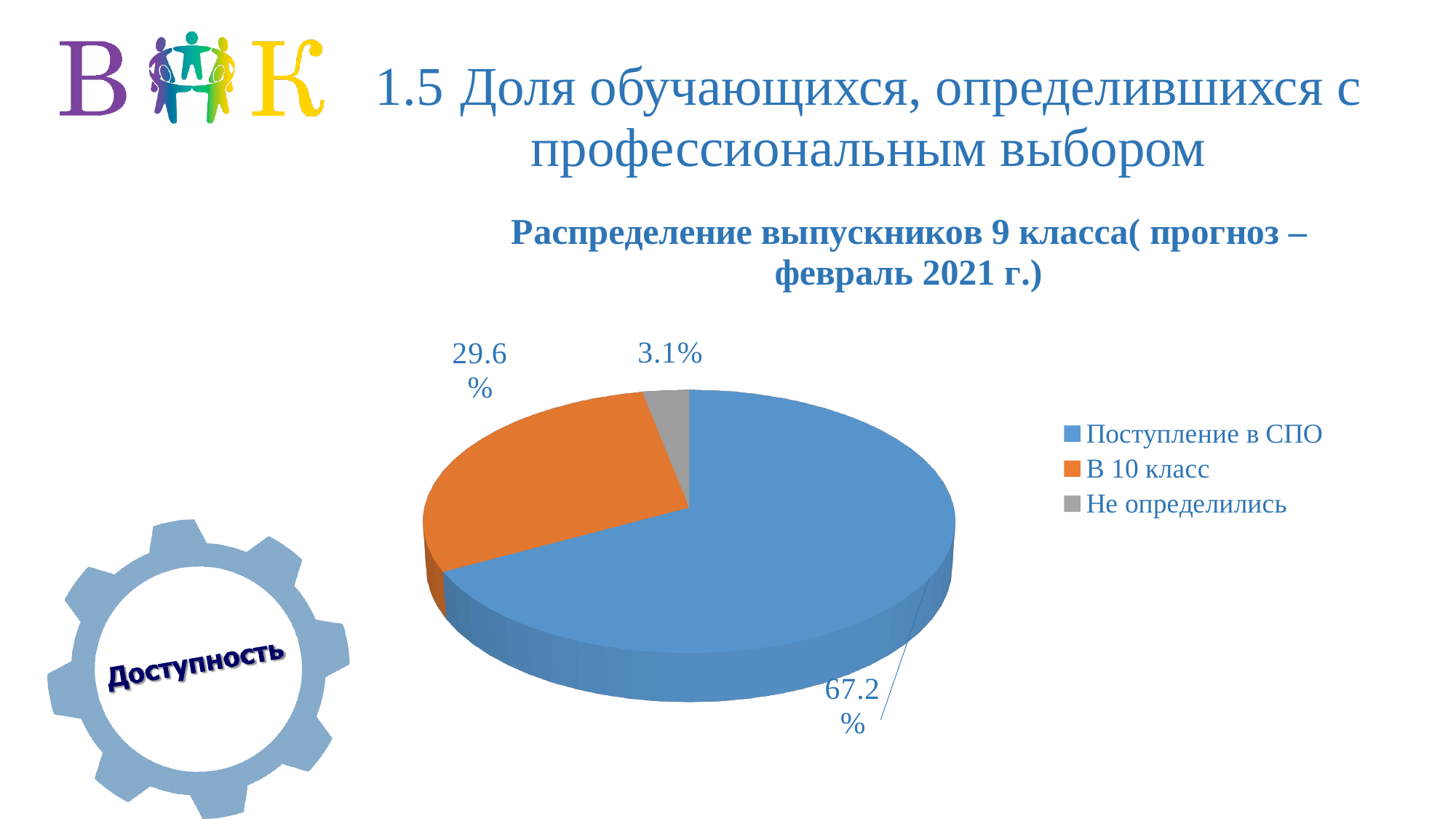
What colour is the slice for "В 10 класс"? orange What share of the pie is labelled for "Поступление в СПО"? 67.2% What share of the pie is labelled for "Не определились"? 3.1% What is the title of the chart? Распределение выпускников 9 класса( прогноз – февраль 2021 г.) Which category has the smallest slice of the pie? Не определились How many slices does the pie chart have? 3 Which is larger, the share for "В 10 класс" or the share for "Не определились"? В 10 класс How many entries does the legend list? 3 What kind of chart is shown on the slide? pie chart What share of the pie is labelled for "В 10 класс"? 29.6% What is the difference in percentage points between "Поступление в СПО" and "В 10 класс"? 37.6 Which category has the largest slice of the pie? Поступление в СПО